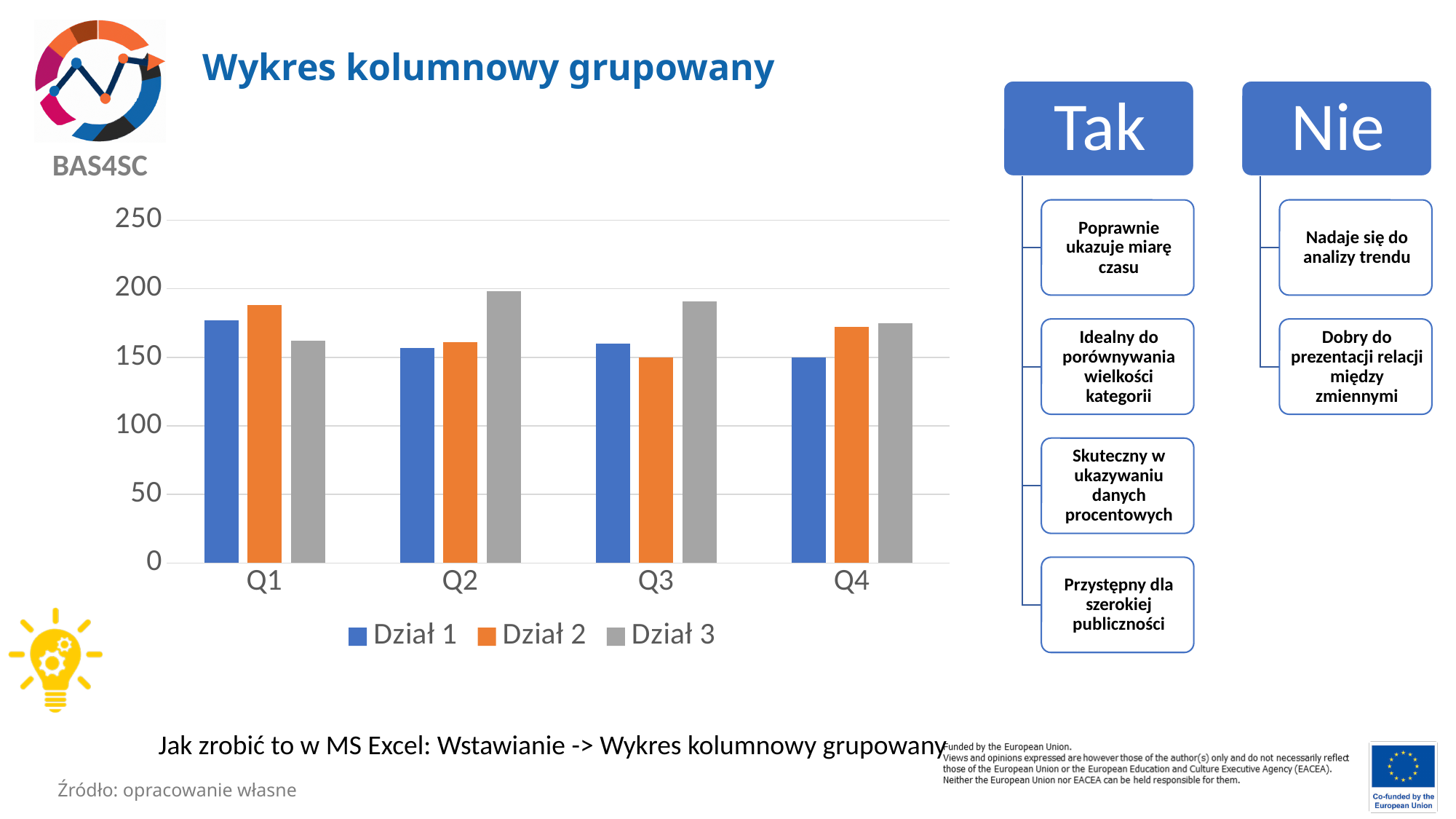
What is the title shown above the chart? Wykres kolumnowy grupowany What kind of chart is shown on the slide? bar chart Which series has the lowest value in Q1? Dział 3 How many series does the chart's legend list? 3 How many categories are shown on the x axis of the chart? 4 Which series has the lowest value in Q4? Dział 1 In Q2, which is larger: the value for Dział 1 or the value for Dział 3? Dział 3 Which series has the highest value in Q3? Dział 3 Is the value for Dział 3 in Q2 greater or less than 150? greater Which series has the highest value in Q2? Dział 3 What are the series names listed in the chart's legend? Dział 1, Dział 2, Dział 3 Is the value for Dział 2 in Q1 greater or less than 200? less